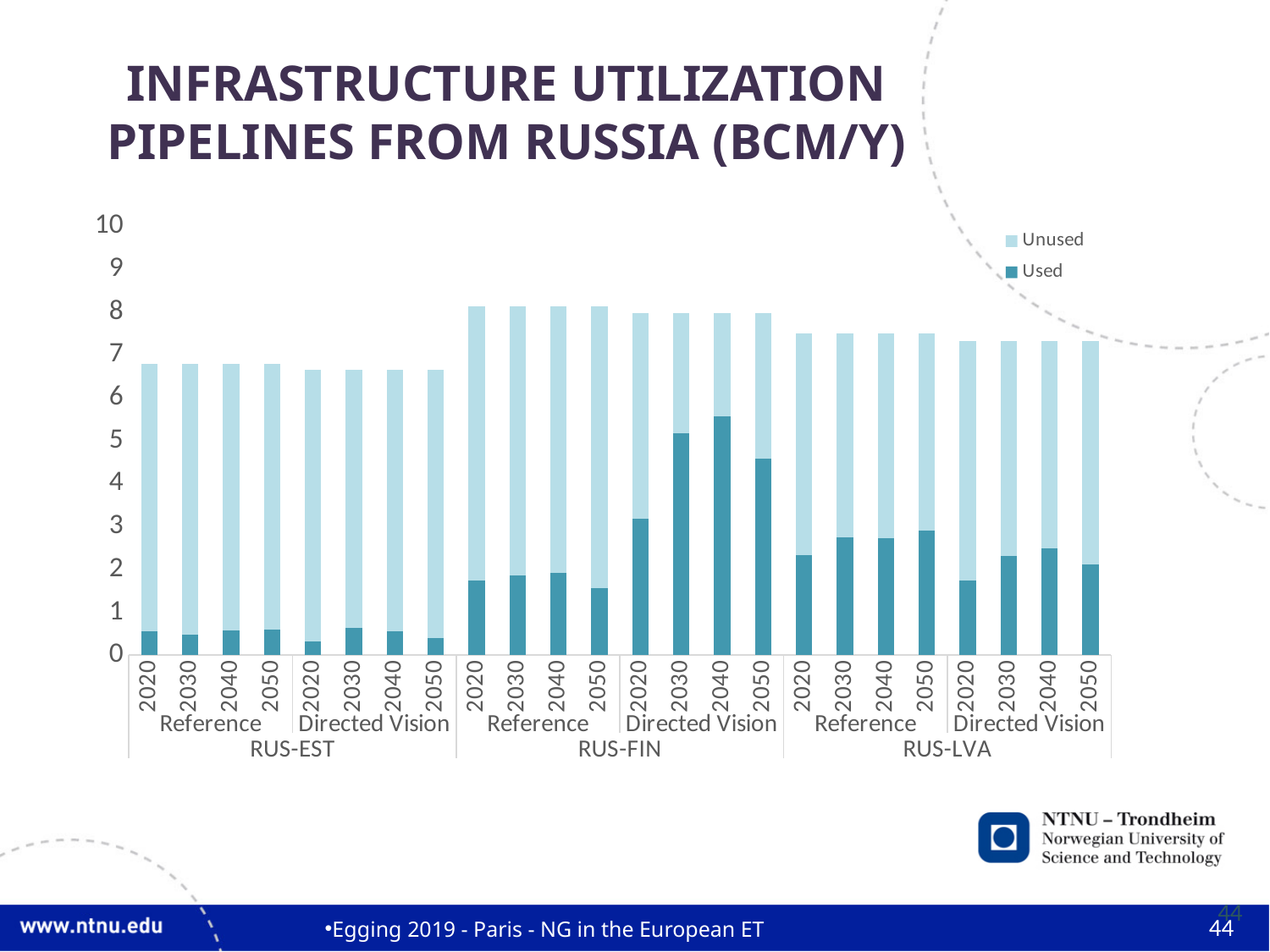
Is the Used value for RUS-FIN Directed Vision 2040 greater or less than 5? greater What are the two series named in the legend? Unused and Used Is the Used value for RUS-EST Reference 2020 greater or less than 1? less How many bars are plotted in the chart in total? 24 Which has the larger Used value: RUS-FIN Directed Vision 2030 or RUS-LVA Reference 2030? RUS-FIN Directed Vision 2030 Which bar has the largest Used portion? RUS-FIN Directed Vision 2040 Is the total bar height for RUS-FIN Reference 2020 greater or less than 7? greater Which pipeline group has the lowest Used values overall? RUS-EST What kind of chart is shown on the slide? Stacked bar chart Does the Used value in the RUS-FIN Directed Vision scenario rise or fall from 2020 to 2040? Rise How many series does the legend list? 2